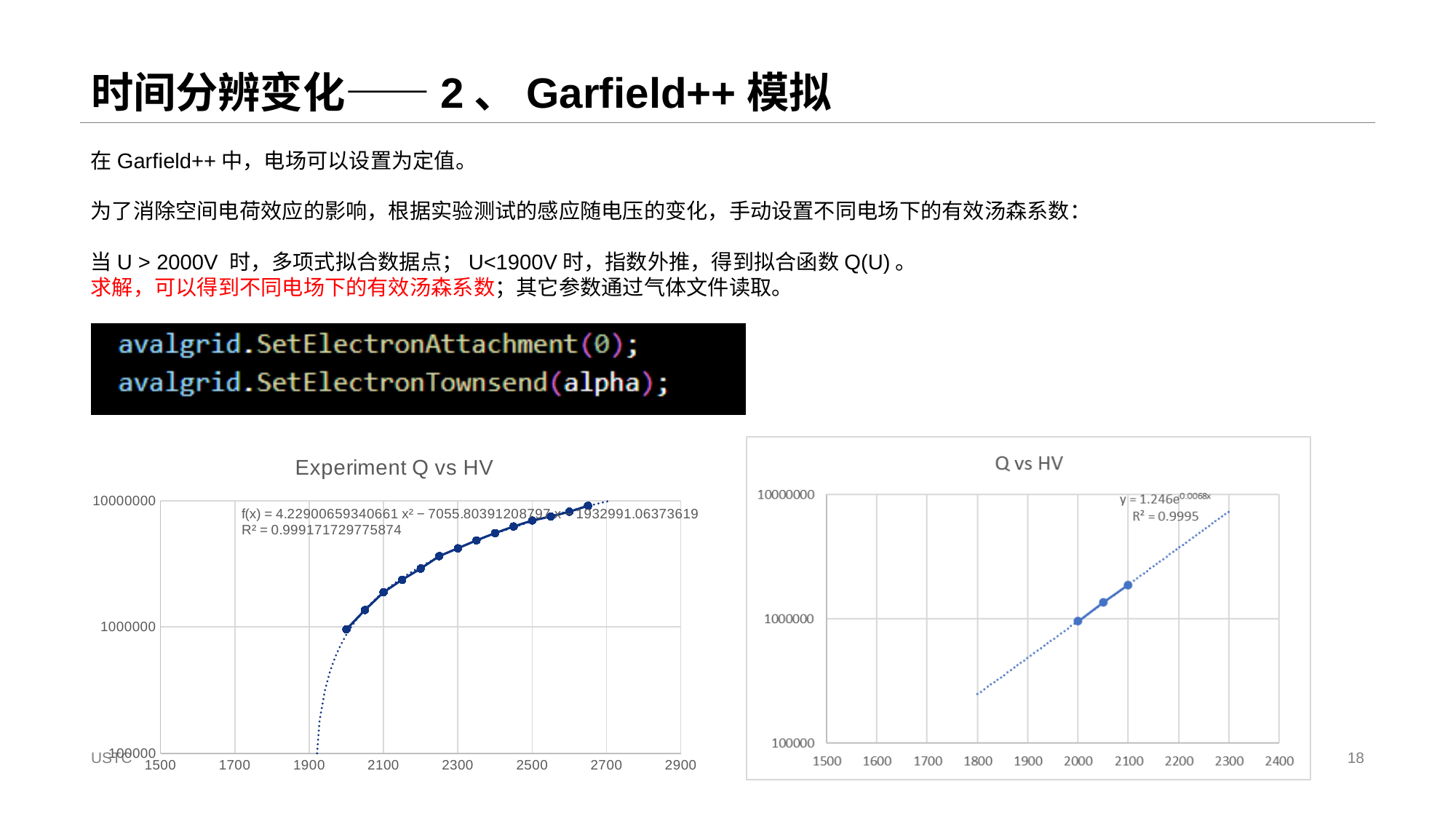
In the left chart "Experiment Q vs HV", which plotted point has the highest value, the one at HV = 2000 or the one at HV = 2650? HV = 2650 What is the title of the left chart? Experiment Q vs HV In the left chart "Experiment Q vs HV", is the value at HV = 2650 greater or less than 10000000? less In the left chart "Experiment Q vs HV", do the plotted values rise or fall as HV increases along the x axis? rise What kind of chart is the left chart titled "Experiment Q vs HV"? scatter chart with a fitted curve In the right chart "Q vs HV", which plotted point is larger, the one at HV = 2000 or the one at HV = 2100? HV = 2100 What is the R² value shown on the right chart "Q vs HV"? 0.9995 In the right chart "Q vs HV", is the value at HV = 2100 greater or less than 1000000? greater In the left chart "Experiment Q vs HV", is the value at HV = 2600 greater or less than 1000000? greater In the right chart "Q vs HV", do the plotted values rise or fall as HV increases along the x axis? rise In the right chart "Q vs HV", how many data points are plotted? 3